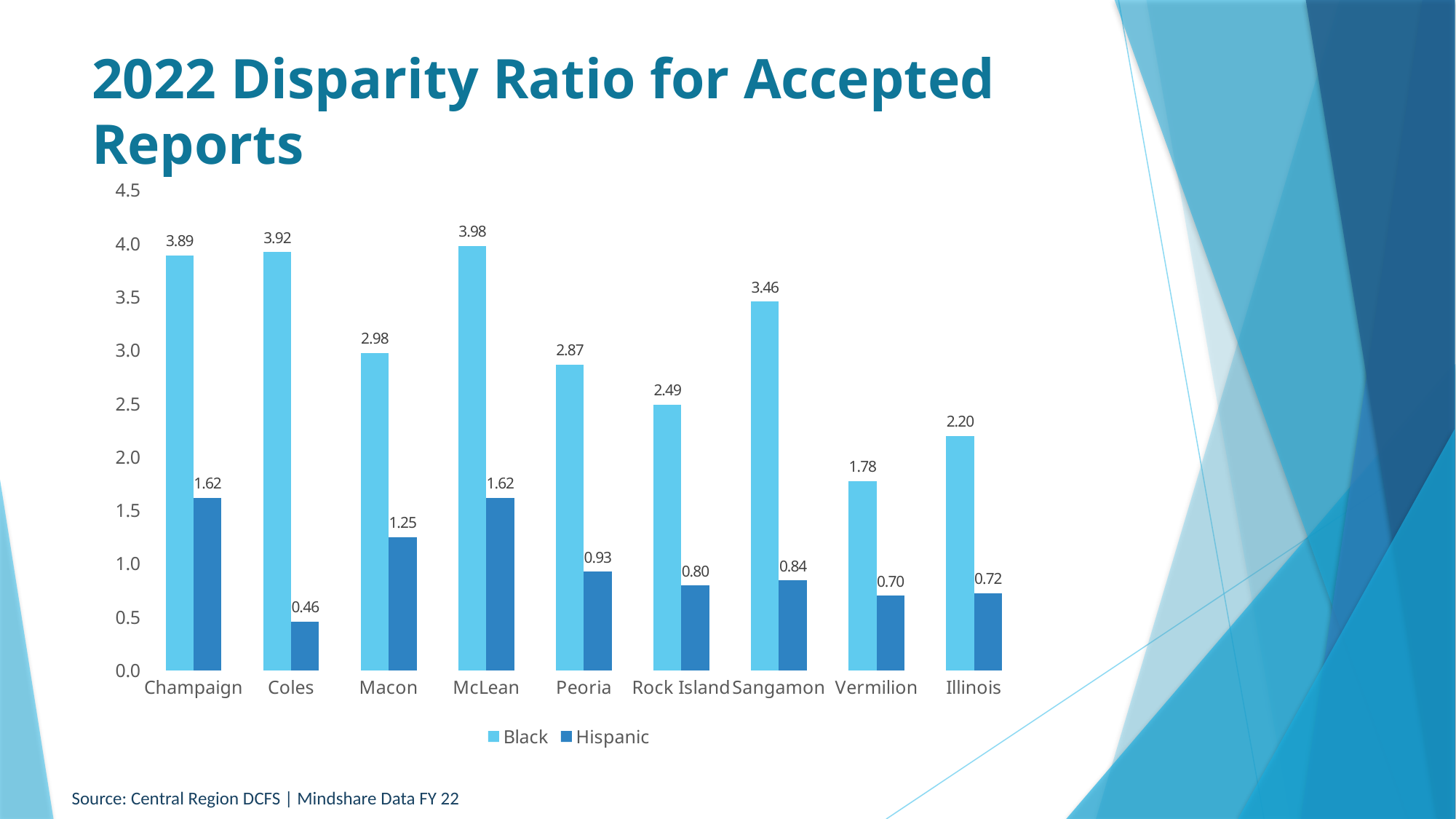
What is the title of the chart on the slide? 2022 Disparity Ratio for Accepted Reports How many categories are shown on the x axis? 9 How many series does the legend list? 2 What is the Black disparity ratio for McLean? 3.98 Which category has the highest Black disparity ratio? McLean Is the Black disparity ratio for Vermilion greater or less than 2.0? less What is the Black disparity ratio for Illinois? 2.20 What kind of chart is shown on the slide? bar chart What is the difference between the Black and Hispanic disparity ratios for Champaign? 2.27 Which category has the lowest Hispanic disparity ratio? Coles Which is larger, the Black disparity ratio for Sangamon or for Macon? Sangamon What is the Hispanic disparity ratio for Coles? 0.46